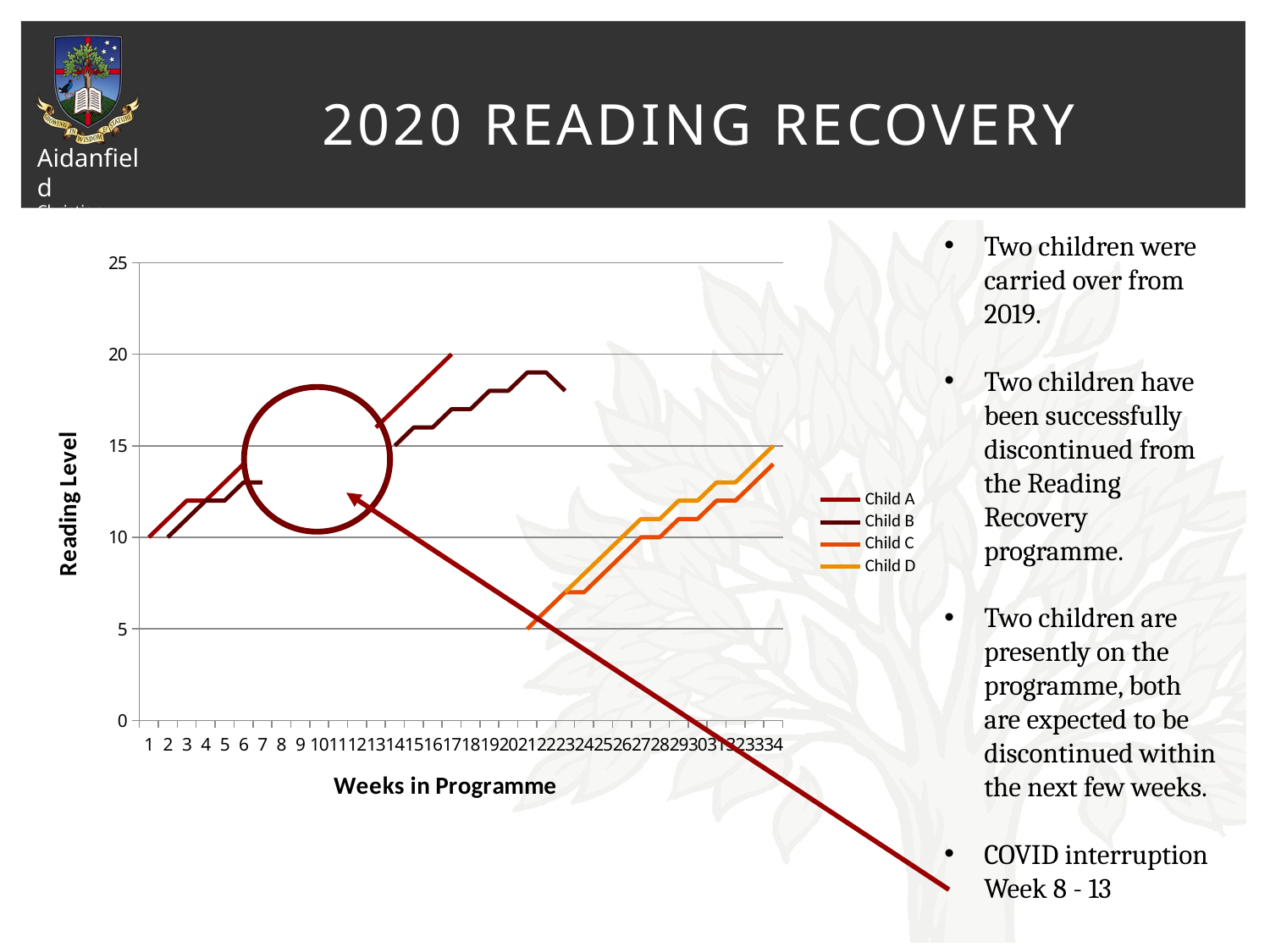
Is Child C's starting reading level greater or less than 10? less What reading level does Child C start at in week 21? 5 At week 34, which child has the higher reading level, Child C or Child D? Child D How many series does the chart's legend list? 4 Is Child A's final reading level greater or less than 15? greater What is the title of the y axis of the chart? Reading Level Which child starts the programme at the lowest reading level? Child C What kind of chart is shown on the slide? line chart Does Child A's reading level rise or fall over the weeks in the programme? rise What reading level does Child A start at in week 1? 10 What is the title of the x axis of the chart? Weeks in Programme Is Child B's final reading level greater or less than 15? greater